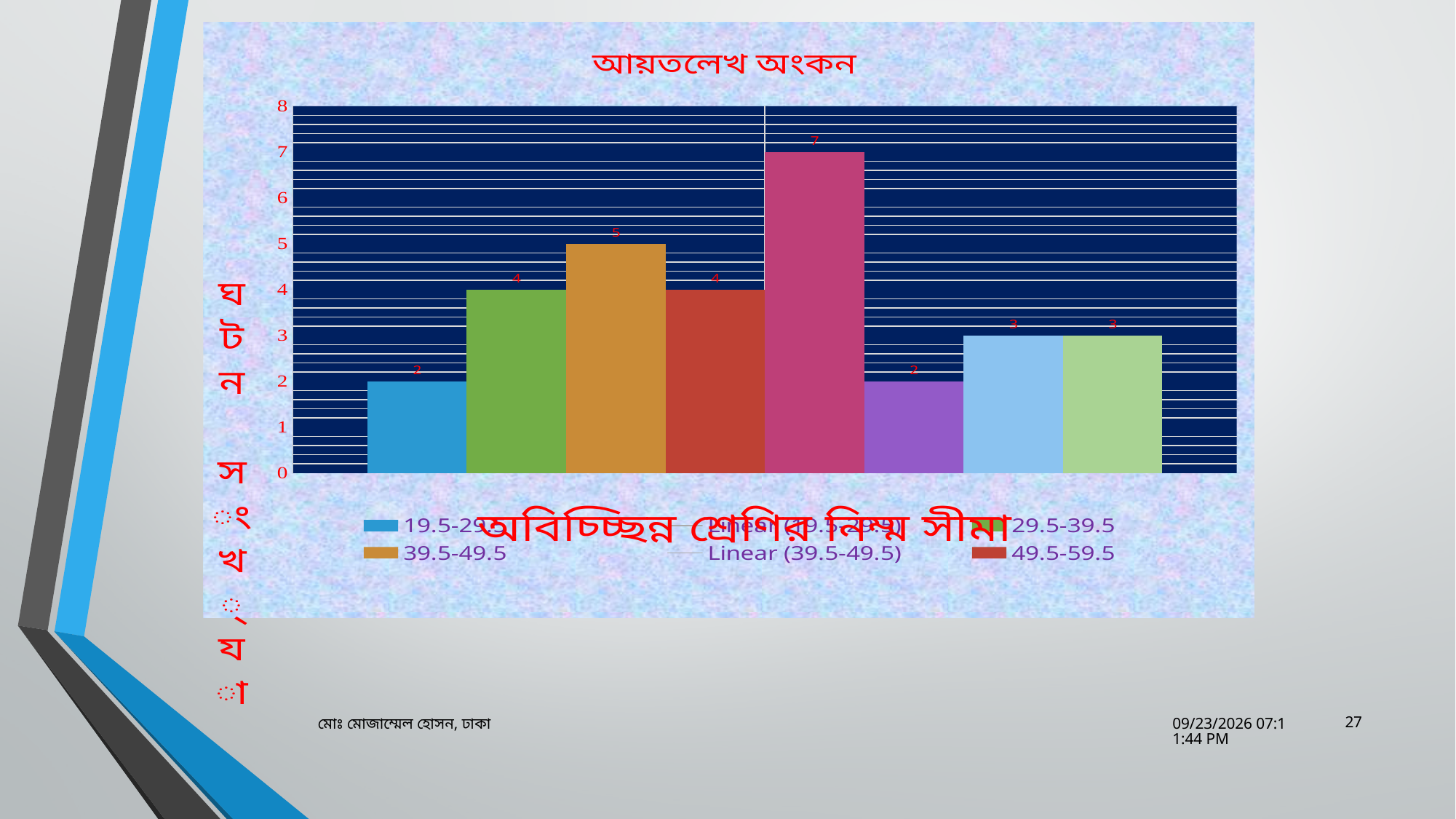
What is the value of the bar for 29.5-39.5? 4 What kind of chart is shown on the slide? bar chart Is the value for 49.5-59.5 greater or less than 3? greater What is the value of the bar for 19.5-29.5? 2 What is the lowest value labelled on any bar in the chart? 2 What is the value of the bar for 39.5-49.5? 5 Which has the larger value, 29.5-39.5 or 39.5-49.5? 39.5-49.5 What is the title of the chart? আয়তলেখ অংকন What is the value of the bar for 49.5-59.5? 4 What is the difference between the values for 39.5-49.5 and 19.5-29.5? 3 How many bars are plotted in the chart? 8 What is the highest value labelled on any bar in the chart? 7